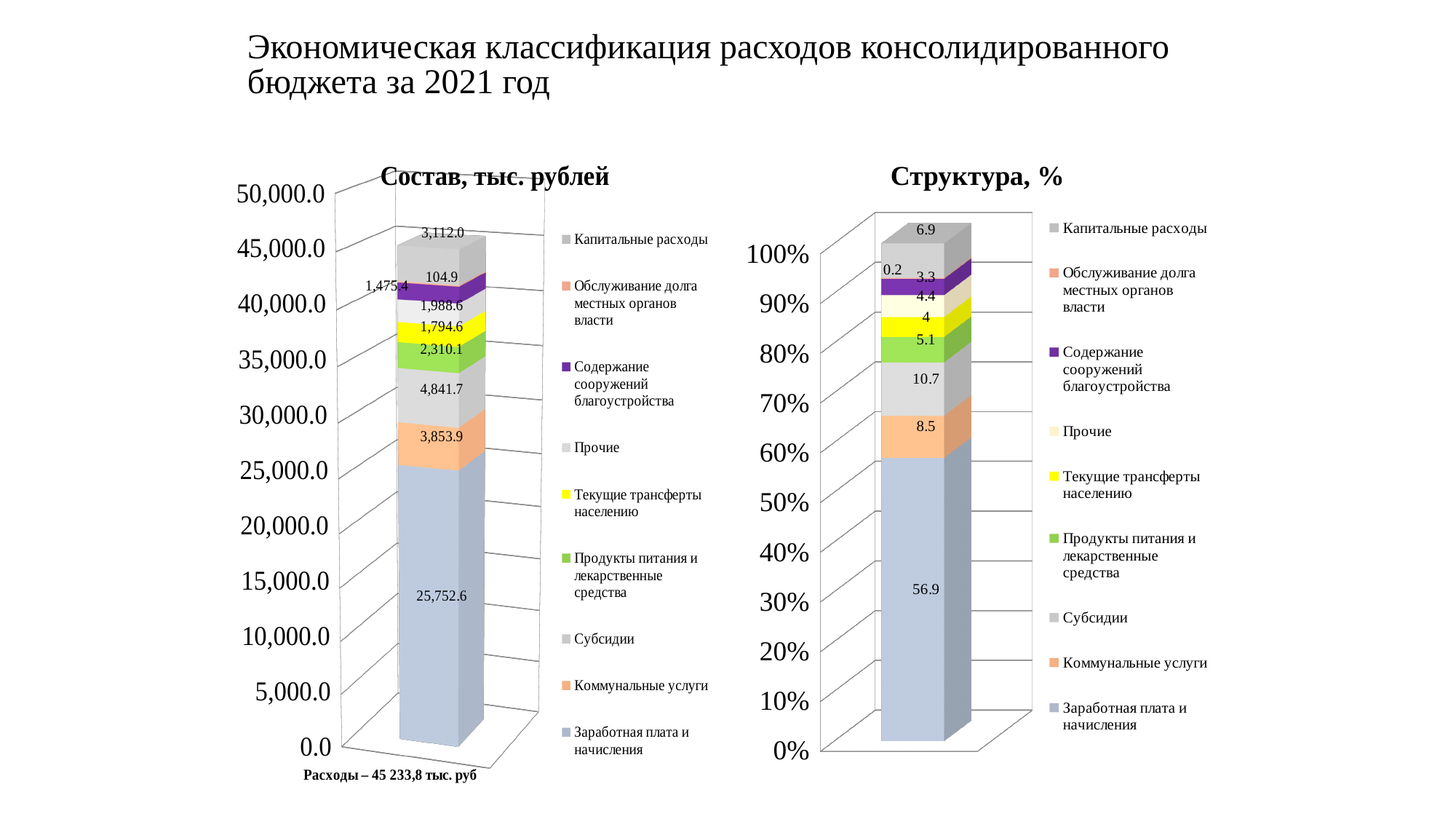
On the chart titled "Структура, %", what is the value for Коммунальные услуги? 8.5 On the chart titled "Состав, тыс. рублей", what is the value for Заработная плата и начисления? 25,752.6 On the chart titled "Состав, тыс. рублей", which series has the smallest value? Обслуживание долга местных органов власти On the chart titled "Состав, тыс. рублей", what is the value for Субсидии? 4,841.7 What kind of chart is the chart titled "Состав, тыс. рублей"? Stacked bar chart On the chart titled "Состав, тыс. рублей", what is the difference between Субсидии and Коммунальные услуги? 987.8 On the chart titled "Состав, тыс. рублей", which is larger: Капитальные расходы or Продукты питания и лекарственные средства? Капитальные расходы On the chart titled "Состав, тыс. рублей", which series has the largest value? Заработная плата и начисления On the chart titled "Состав, тыс. рублей", what is the value for Обслуживание долга местных органов власти? 104.9 On the chart titled "Структура, %", what is the difference between Субсидии and Продукты питания и лекарственные средства? 5.6 How many series does the legend of the chart titled "Структура, %" list? 9 On the chart titled "Структура, %", what is the value for Капитальные расходы? 6.9